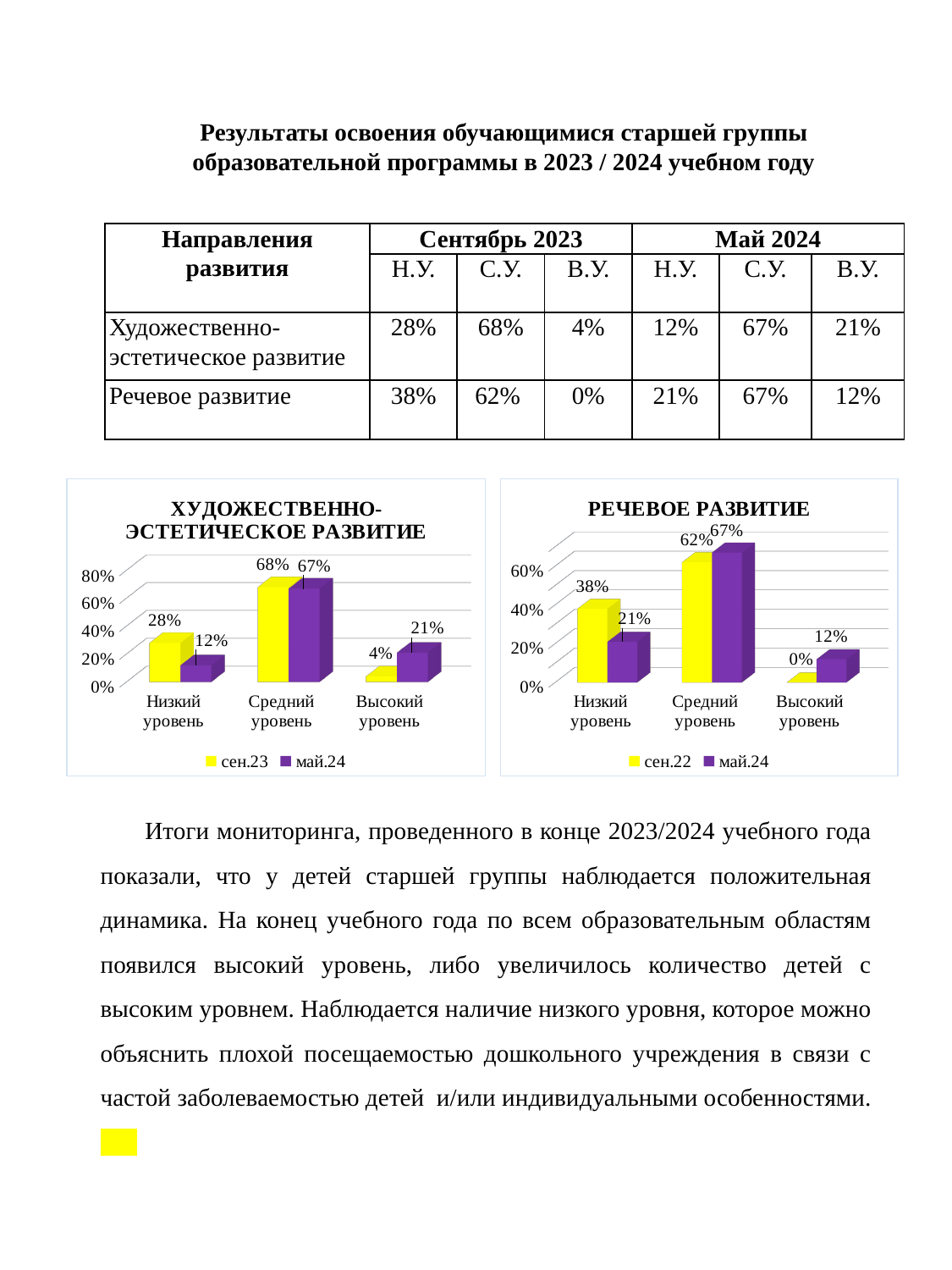
In the chart titled «РЕЧЕВОЕ РАЗВИТИЕ», which category has the lowest value in the май.24 series? Высокий уровень In the chart titled «РЕЧЕВОЕ РАЗВИТИЕ», what is the difference between the сен.22 and май.24 values for «Низкий уровень»? 17% In the chart titled «РЕЧЕВОЕ РАЗВИТИЕ», which is larger for «Средний уровень»: the сен.22 value or the май.24 value? май.24 In the chart titled «ХУДОЖЕСТВЕННО-ЭСТЕТИЧЕСКОЕ РАЗВИТИЕ», how many series does the legend list? 2 In the chart titled «ХУДОЖЕСТВЕННО-ЭСТЕТИЧЕСКОЕ РАЗВИТИЕ», what is the value for «Низкий уровень» in the сен.23 series? 28% In the chart titled «РЕЧЕВОЕ РАЗВИТИЕ», what is the value for «Высокий уровень» in the сен.22 series? 0% In the chart titled «РЕЧЕВОЕ РАЗВИТИЕ», what is the value for «Низкий уровень» in the сен.22 series? 38% In the chart titled «ХУДОЖЕСТВЕННО-ЭСТЕТИЧЕСКОЕ РАЗВИТИЕ», which category has the highest value in the сен.23 series? Средний уровень In the chart titled «ХУДОЖЕСТВЕННО-ЭСТЕТИЧЕСКОЕ РАЗВИТИЕ», what is the value for «Высокий уровень» in the май.24 series? 21% How many categories are shown on the x axis of the chart titled «РЕЧЕВОЕ РАЗВИТИЕ»? 3 In the chart titled «ХУДОЖЕСТВЕННО-ЭСТЕТИЧЕСКОЕ РАЗВИТИЕ», what is the difference between the сен.23 and май.24 values for «Низкий уровень»? 16% What type of chart is the chart titled «ХУДОЖЕСТВЕННО-ЭСТЕТИЧЕСКОЕ РАЗВИТИЕ»? Bar chart